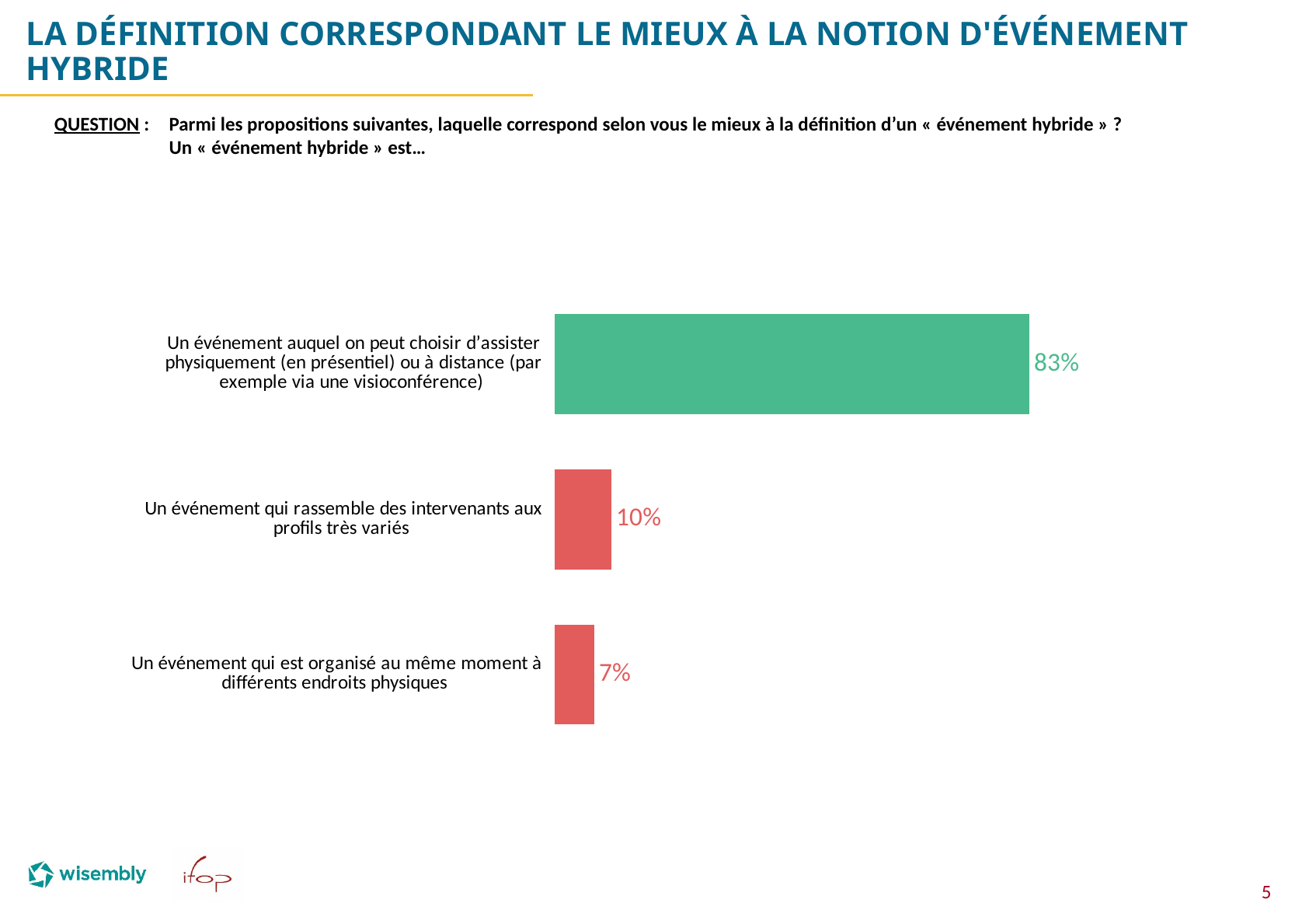
How many definitions (categories) are shown in the chart? 3 Which received a larger share: "Un événement qui rassemble des intervenants aux profils très variés" or "Un événement qui est organisé au même moment à différents endroits physiques"? Un événement qui rassemble des intervenants aux profils très variés Which definition received the highest percentage? Un événement auquel on peut choisir d'assister physiquement (en présentiel) ou à distance (par exemple via une visioconférence) What colour is the bar for the highest-scoring definition? Green What percentage chose "Un événement auquel on peut choisir d'assister physiquement (en présentiel) ou à distance (par exemple via une visioconférence)"? 83% What is the total of the three percentages shown in the chart? 100% What percentage chose "Un événement qui est organisé au même moment à différents endroits physiques"? 7% What is the difference in percentage points between the top definition (83%) and "Un événement qui rassemble des intervenants aux profils très variés"? 73 What type of chart is shown on the slide? Bar chart What percentage chose "Un événement qui rassemble des intervenants aux profils très variés"? 10% What is the difference in percentage points between "Un événement qui rassemble des intervenants aux profils très variés" and "Un événement qui est organisé au même moment à différents endroits physiques"? 3 Which definition received the lowest percentage? Un événement qui est organisé au même moment à différents endroits physiques